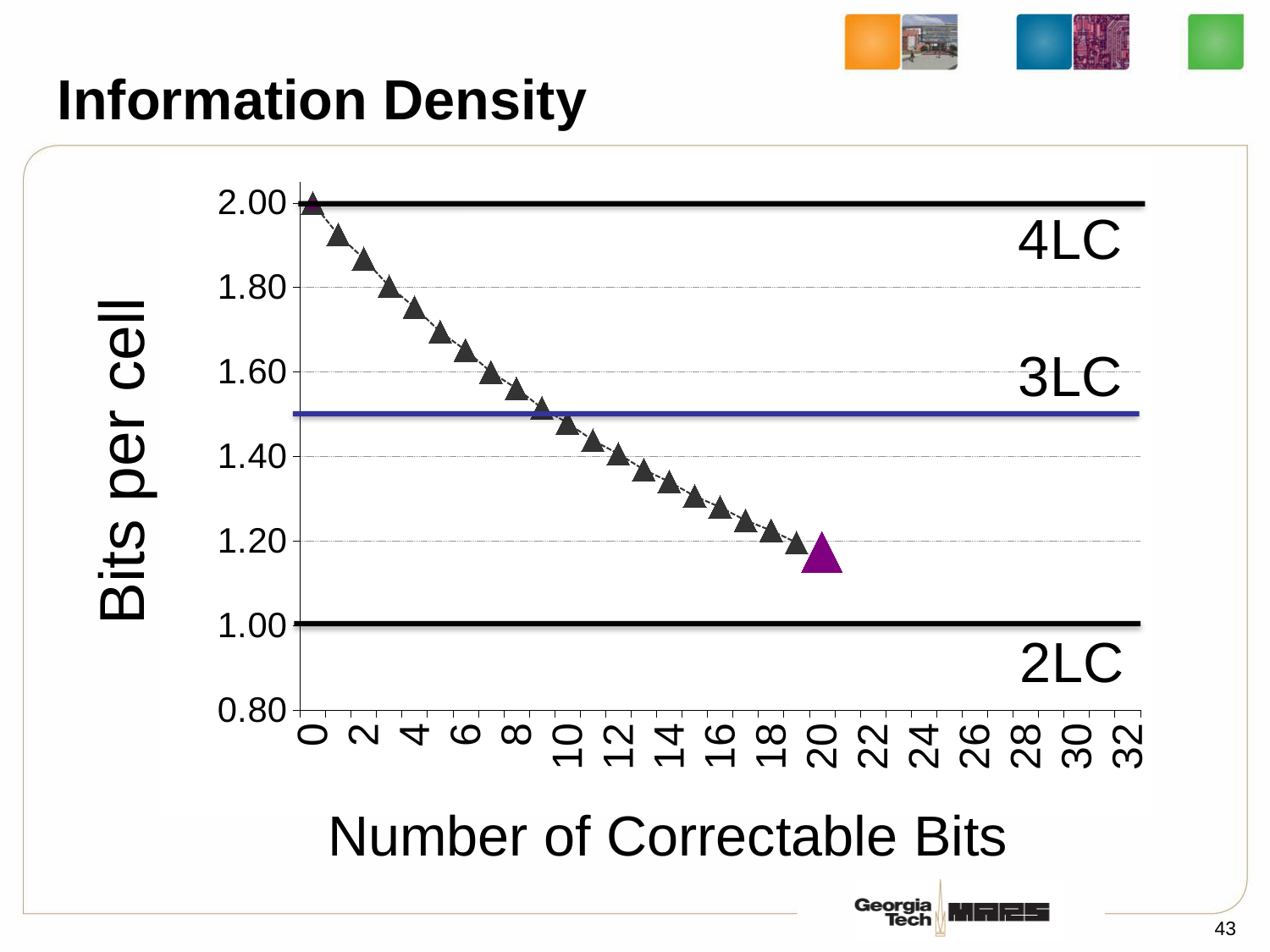
What is the label on the vertical axis of the chart? Bits per cell Is the bits-per-cell value at 10 correctable bits greater or less than 1.60? less Is the bits-per-cell value at 2 correctable bits greater or less than 1.80? greater What is the bits-per-cell value at 0 correctable bits? 2.00 Do the plotted bits-per-cell values rise or fall as the number of correctable bits increases? fall At what bits-per-cell value is the 2LC line drawn? 1.00 At which number of correctable bits is the plotted bits-per-cell value lowest? 20 At which number of correctable bits is the plotted bits-per-cell value highest? 0 What kind of chart is shown on the slide? line chart Which has the larger bits-per-cell value: 4 correctable bits or 14 correctable bits? 4 correctable bits Is the bits-per-cell value at 16 correctable bits greater or less than 1.40? less At what bits-per-cell value is the 4LC line drawn? 2.00